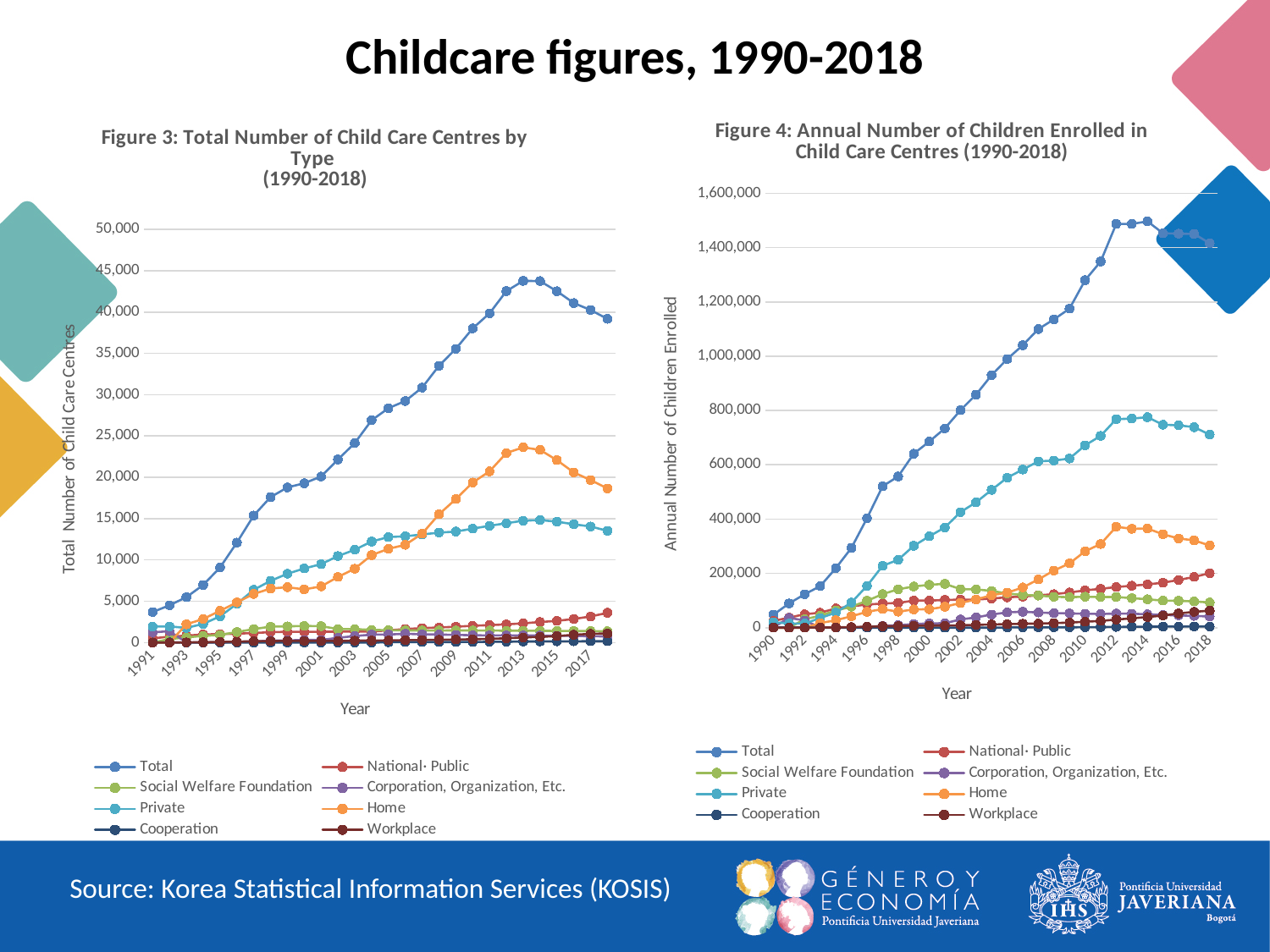
In Figure 3: Total Number of Child Care Centres by Type, which series other than Total has the highest value in 2017? Home How many series does the legend of Figure 4: Annual Number of Children Enrolled in Child Care Centres list? 8 In Figure 4: Annual Number of Children Enrolled in Child Care Centres, is the value for Home in 2012 greater or less than 300,000? greater In Figure 4: Annual Number of Children Enrolled in Child Care Centres, is the value for Private in 2018 greater or less than 800,000? less In Figure 3: Total Number of Child Care Centres by Type, is the value for Home in 2013 greater or less than 20,000? greater In Figure 3: Total Number of Child Care Centres by Type, which is larger in 2017, Private or Home? Home What kind of chart is Figure 3: Total Number of Child Care Centres by Type? Line chart What is the y-axis label of Figure 4: Annual Number of Children Enrolled in Child Care Centres? Annual Number of Children Enrolled In Figure 4: Annual Number of Children Enrolled in Child Care Centres, does the Total series rise or fall from 1990 to 2012? Rise In Figure 4: Annual Number of Children Enrolled in Child Care Centres, which is larger in 2018, Private or Home? Private